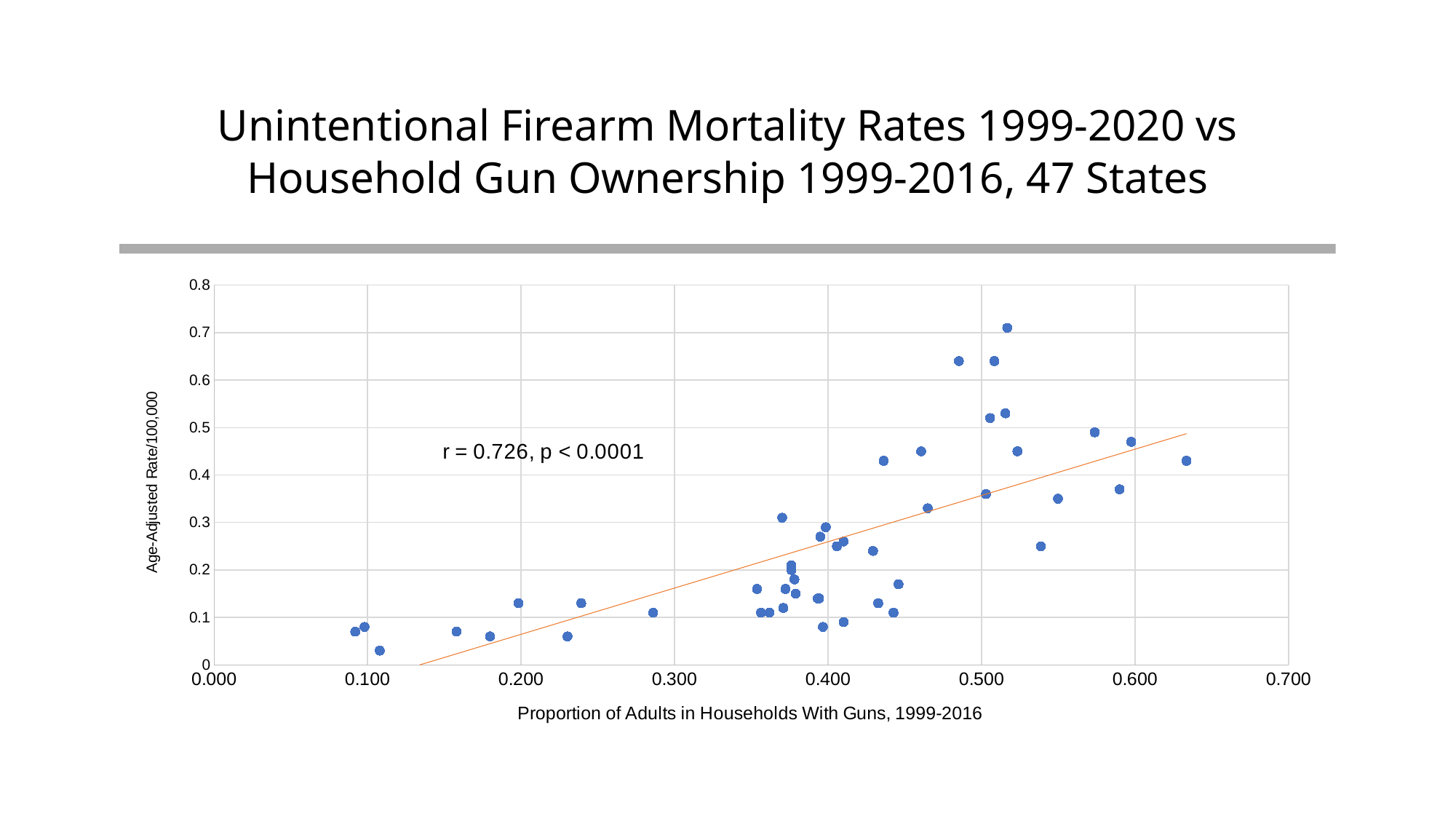
What is the highest value shown on the y axis? 0.8 What kind of chart is shown on the slide? Scatter chart Is the age-adjusted rate of the point with the largest gun-ownership proportion (just above 0.600) greater or less than 0.5? less How many states does the chart title say are included? 47 Is the age-adjusted rate of the point at a gun-ownership proportion of roughly 0.285 greater or less than 0.2? less As the proportion of adults in households with guns increases along the x axis, do the age-adjusted mortality rates generally rise or fall? Rise What is the highest value shown on the x axis? 0.700 What correlation coefficient (r) is printed on the chart? r = 0.726 Is the age-adjusted rate of the lowest point on the chart greater or less than 0.1? less